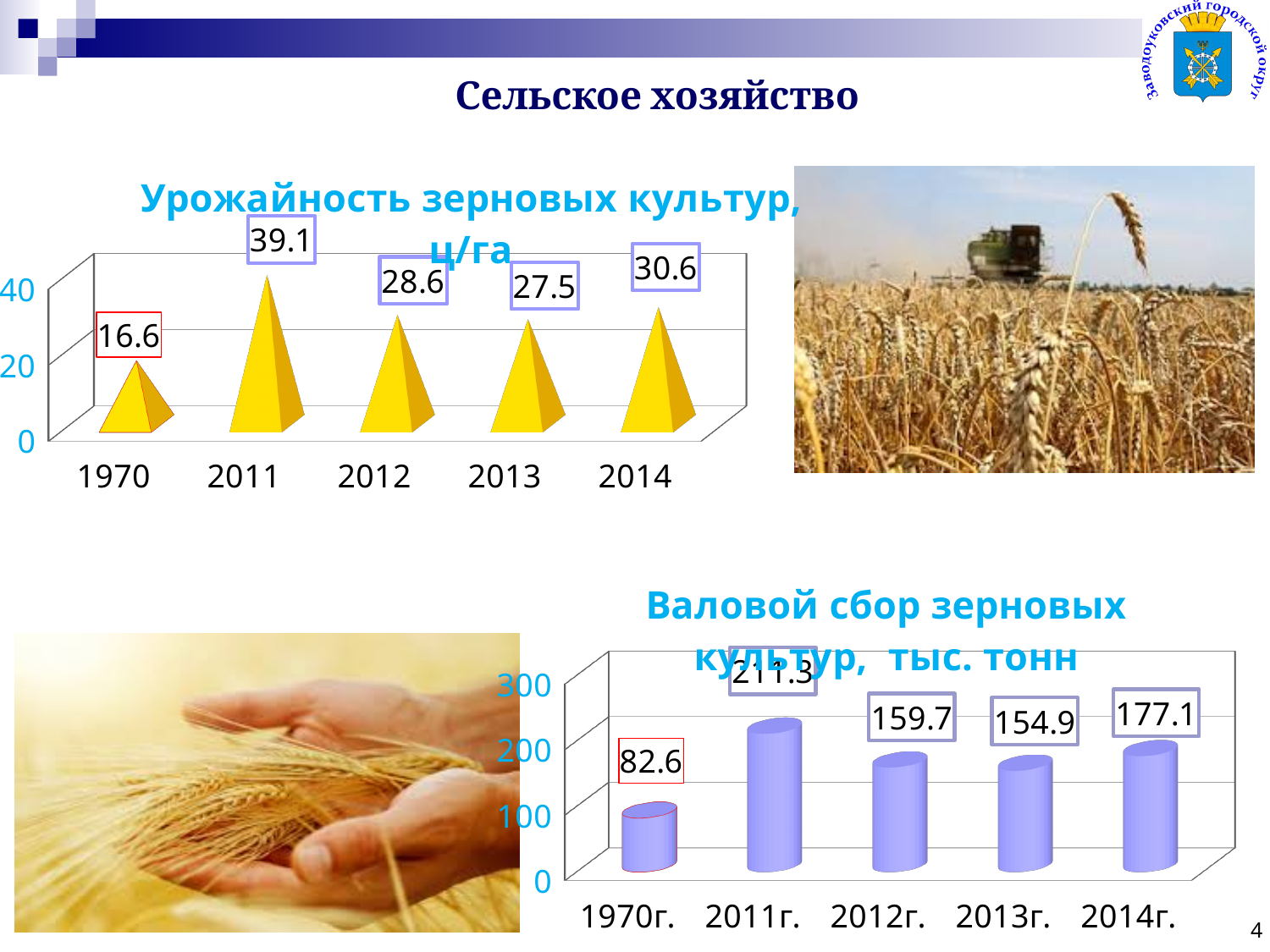
In the chart 'Валовой сбор зерновых культур, тыс. тонн', which is larger, the value for 2012г. or 2013г.? 2012г. In the chart 'Урожайность зерновых культур, ц/га', how many years are shown on the x axis? 5 In the chart 'Урожайность зерновых культур, ц/га', what is the value for 2011? 39.1 In the chart 'Валовой сбор зерновых культур, тыс. тонн', what is the value for 2012г.? 159.7 In the chart 'Урожайность зерновых культур, ц/га', what is the difference between the values for 2014 and 2013? 3.1 In the chart 'Урожайность зерновых культур, ц/га', which year has the highest value? 2011 What kind of chart is 'Валовой сбор зерновых культур, тыс. тонн'? bar chart In the chart 'Валовой сбор зерновых культур, тыс. тонн', what is the value for 2014г.? 177.1 In the chart 'Урожайность зерновых культур, ц/га', what is the value for 1970? 16.6 In the chart 'Урожайность зерновых культур, ц/га', which year has the lowest value? 1970 In the chart 'Валовой сбор зерновых культур, тыс. тонн', is the value for 1970г. greater or less than 100? less In the chart 'Валовой сбор зерновых культур, тыс. тонн', which year has the highest value? 2011г.